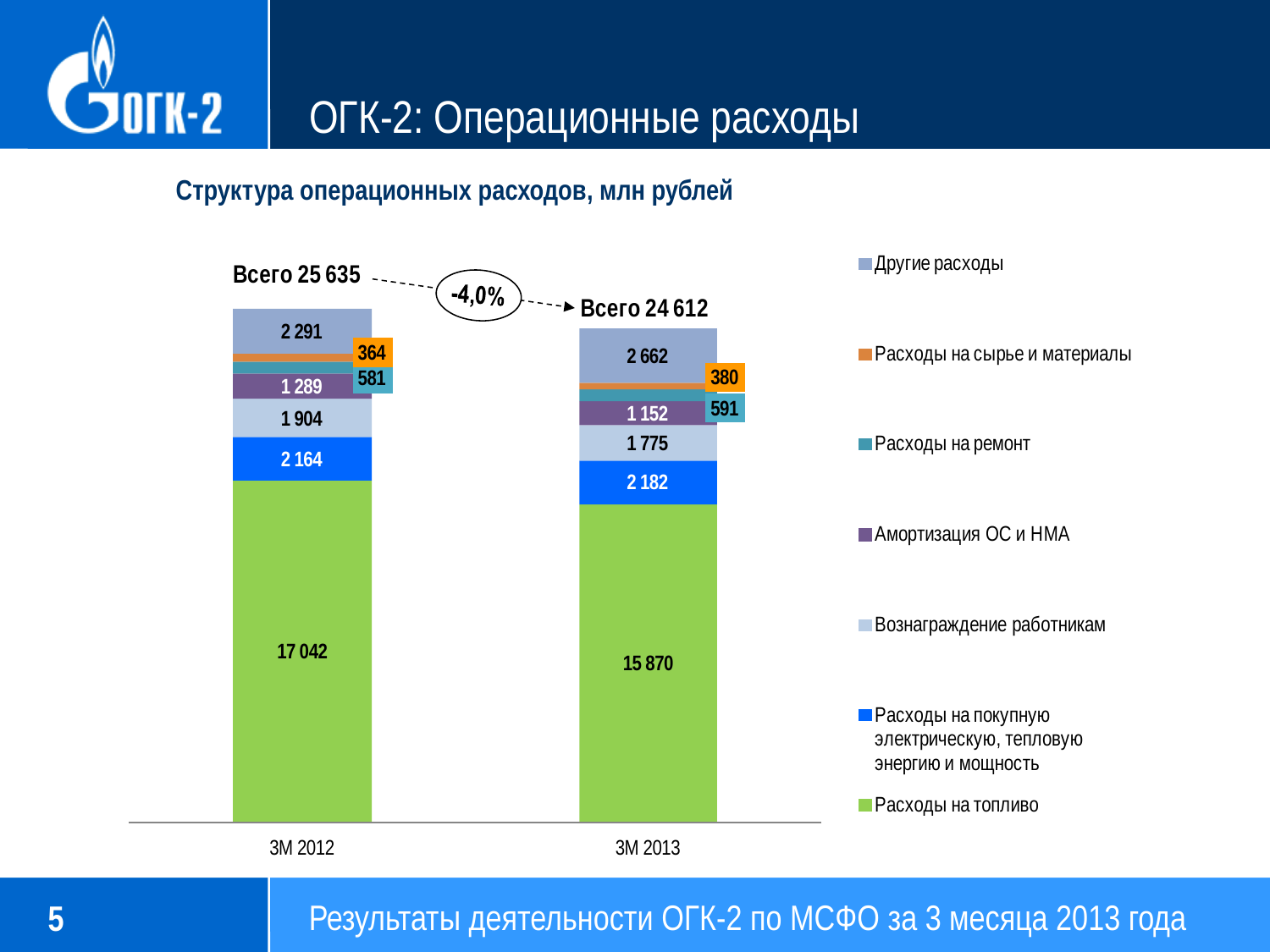
What is the value of Вознаграждение работникам for 3M 2012? 1 904 How many series does the legend list? 7 How many categories (periods) are shown on the x axis? 2 What is the total of the stacked bar for 3M 2012? 25 635 What is the difference between Расходы на топливо in 3M 2012 and 3M 2013? 1 172 What is the value of Расходы на сырье и материалы for 3M 2013? 380 Which is larger: Амортизация ОС и НМА in 3M 2012 or in 3M 2013? 3M 2012 What is the value of Расходы на топливо for 3M 2013? 15 870 What kind of chart is shown on the slide? Stacked bar chart What percentage change between the two totals is shown on the slide? -4,0% Which series has the highest value in 3M 2013? Расходы на топливо What is the total of the stacked bar for 3M 2013? 24 612